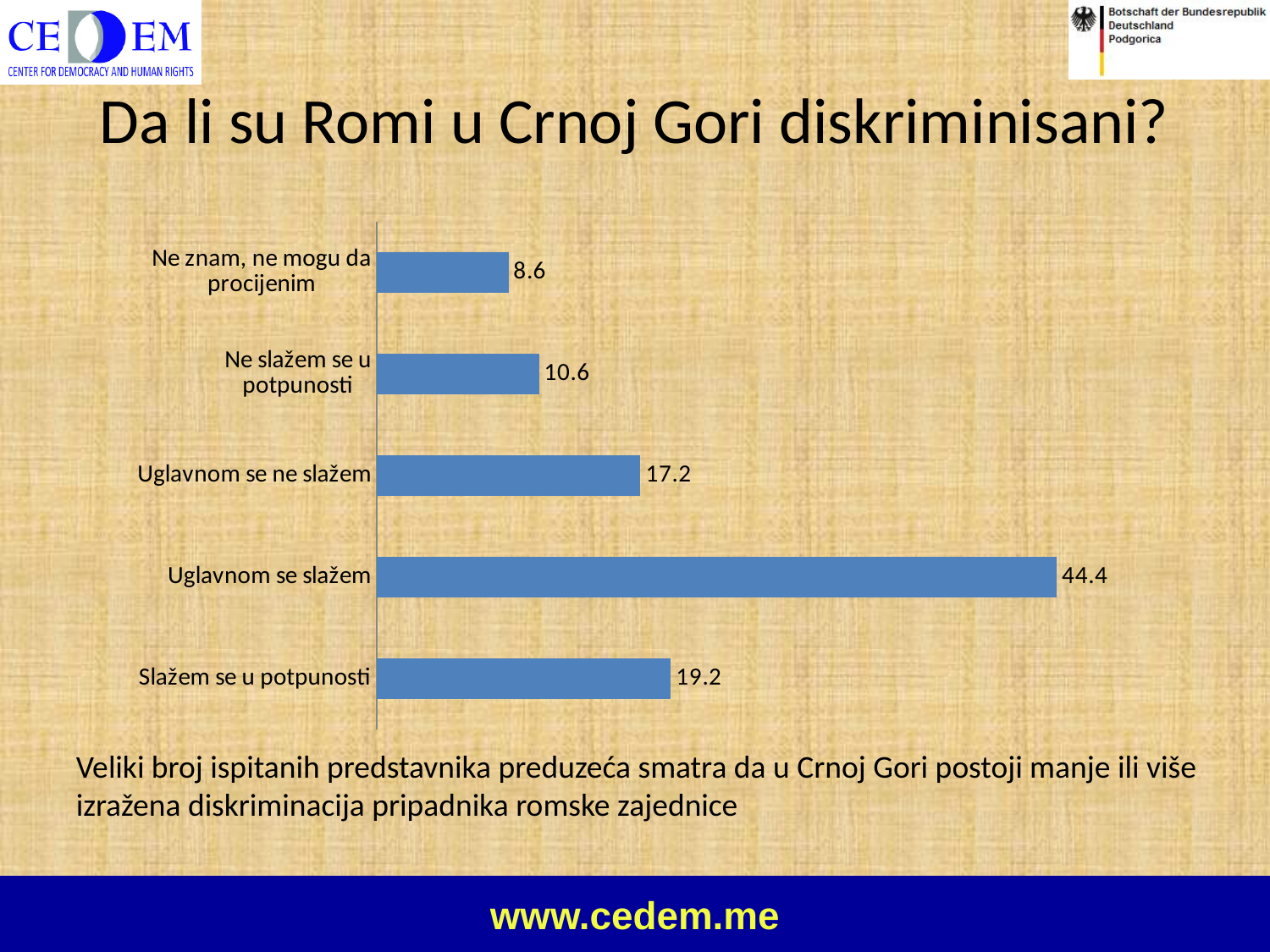
Which category has the highest value? Uglavnom se slažem What is the value for "Slažem se u potpunosti"? 19.2 Which category has the lowest value? Ne znam, ne mogu da procijenim What is the value for "Ne slažem se u potpunosti"? 10.6 What is the value for "Ne znam, ne mogu da procijenim"? 8.6 How many categories are shown in the chart? 5 Which is larger, the value for "Slažem se u potpunosti" or the value for "Uglavnom se ne slažem"? Slažem se u potpunosti What is the difference between the values for "Uglavnom se slažem" and "Slažem se u potpunosti"? 25.2 What is the title of the slide containing the chart? Da li su Romi u Crnoj Gori diskriminisani? What kind of chart is shown on the slide? Bar chart What is the value for "Uglavnom se slažem"? 44.4 What is the difference between the values for "Uglavnom se ne slažem" and "Ne slažem se u potpunosti"? 6.6